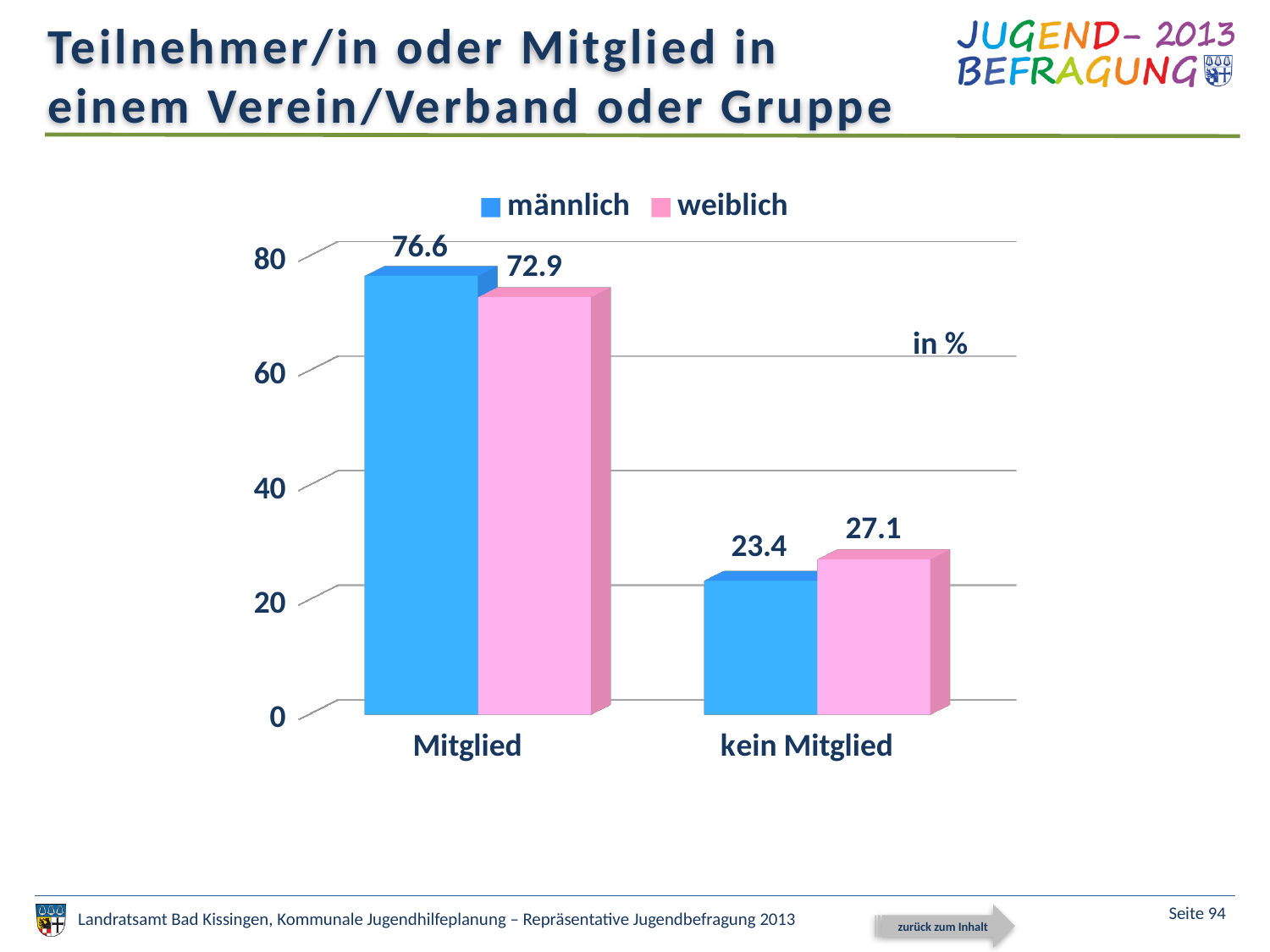
What is the value for weiblich in the Mitglied category? 72.9 What is the difference between the weiblich and männlich values in the kein Mitglied category? 3.7 What is the value for weiblich in the kein Mitglied category? 27.1 How many categories are shown on the x axis? 2 What kind of chart is shown on the slide? bar chart What is the value for männlich in the Mitglied category? 76.6 Which category has the lowest value for weiblich? kein Mitglied How many series does the legend list? 2 In the kein Mitglied category, which series has the larger value, männlich or weiblich? weiblich What is the value for männlich in the kein Mitglied category? 23.4 Which category has the highest value for männlich? Mitglied What is the difference between the männlich and weiblich values in the Mitglied category? 3.7